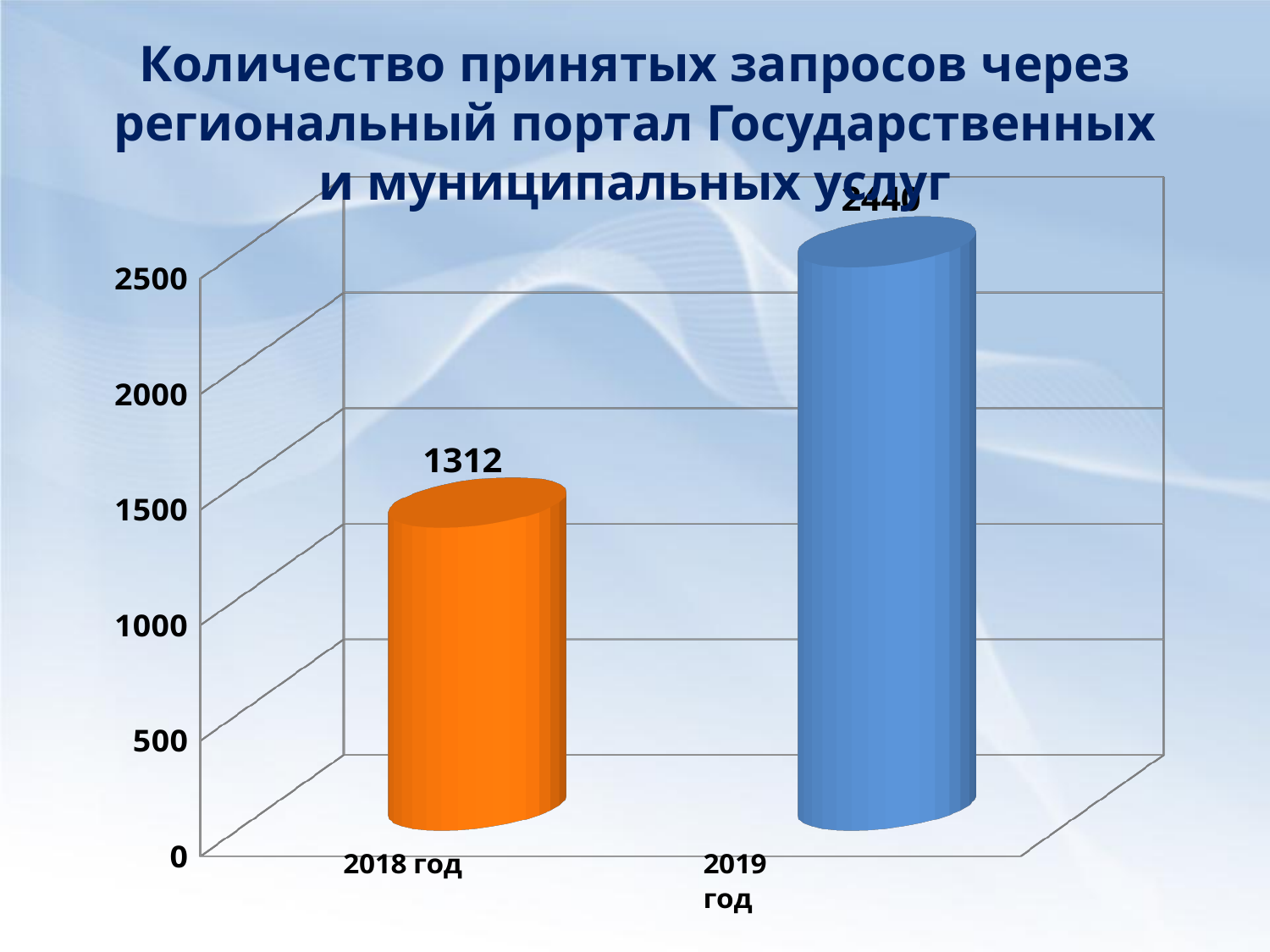
What colour is the bar for 2018 год? orange Is the value for 2019 год greater or less than 2000? greater Which is larger, the value for 2018 год or the value for 2019 год? 2019 год What is the value for 2018 год? 1312 Is the value for 2018 год greater or less than 1500? less What is the value for 2019 год? 2440 What is the difference between the values for 2019 год and 2018 год? 1128 Which year has the lowest value? 2018 год How many categories are shown on the x axis? 2 Do the values rise or fall from 2018 год to 2019 год? rise What kind of chart is shown on the slide? bar chart Which year has the highest value? 2019 год